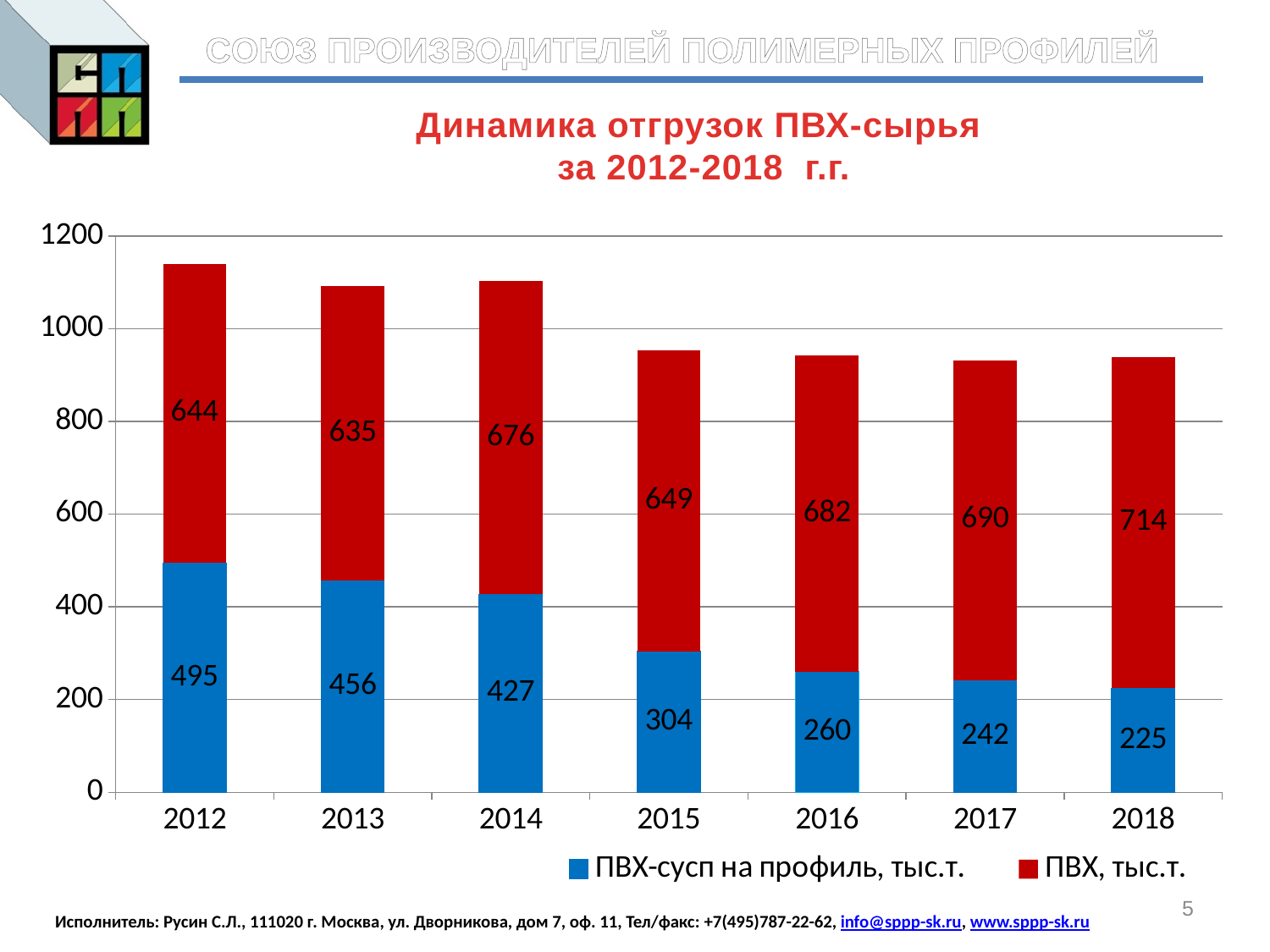
Which is larger: the ПВХ, тыс.т. value for 2014 or for 2013? 2014 Which year has the highest value for ПВХ, тыс.т.? 2018 What is the value of ПВХ, тыс.т. for 2015? 649 What is the value of ПВХ, тыс.т. for 2018? 714 Which year has the lowest value for ПВХ-сусп на профиль, тыс.т.? 2018 What kind of chart is shown on the slide? Stacked bar chart What is the value of ПВХ-сусп на профиль, тыс.т. for 2012? 495 How many years are shown on the x axis? 7 How many series does the legend list? 2 What is the total of the stacked bar for 2012? 1139 What is the total of the stacked bar for 2017? 932 What is the difference between the ПВХ-сусп на профиль, тыс.т. values for 2012 and 2018? 270